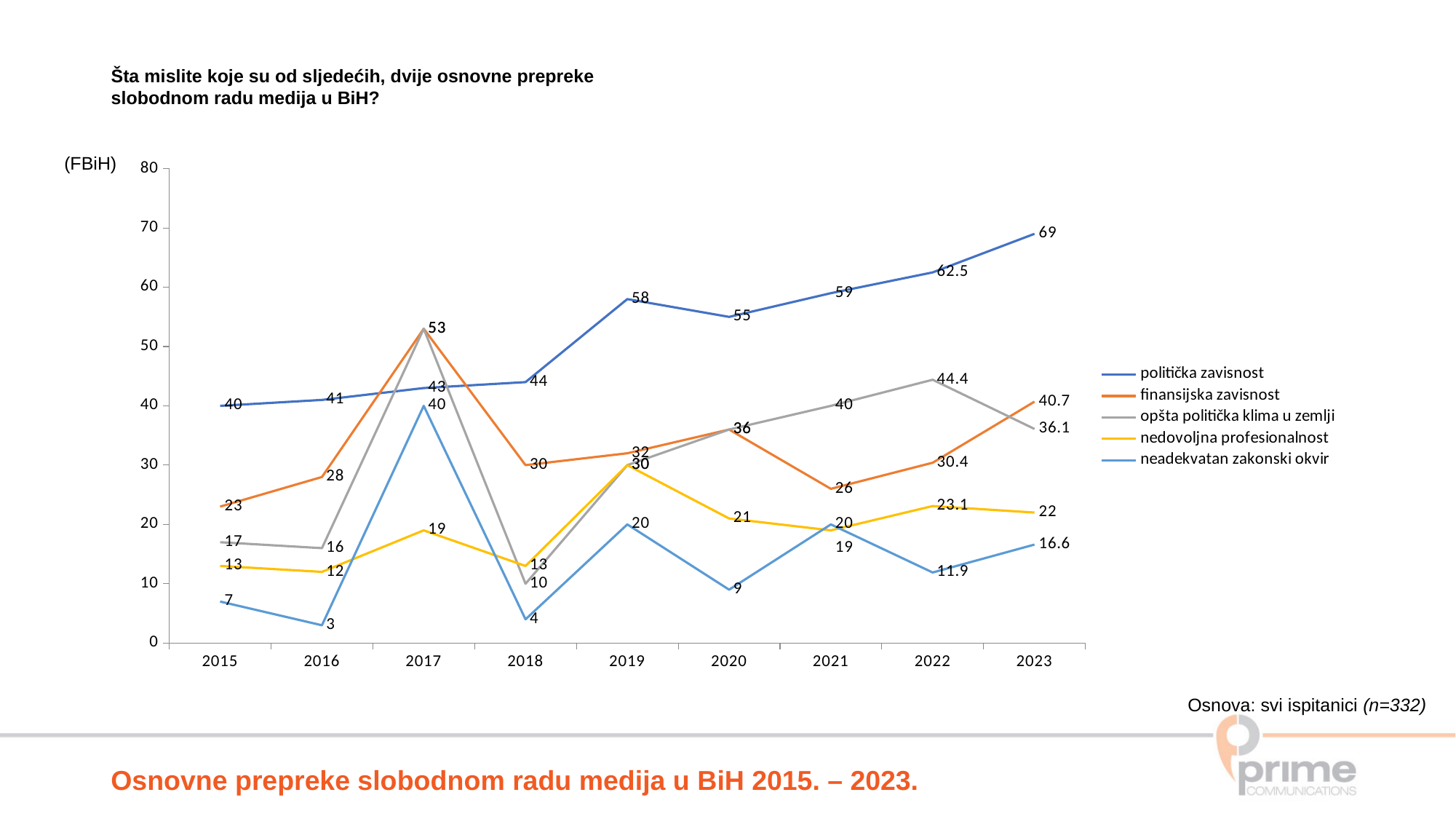
In which year is neadekvatan zakonski okvir at its lowest value? 2016 How many series does the legend list? 5 In which year does politička zavisnost reach its highest value? 2023 Which is larger in 2023: finansijska zavisnost or opšta politička klima u zemlji? finansijska zavisnost What is the value for politička zavisnost in 2023? 69 Does politička zavisnost generally rise or fall from 2015 to 2023? rise What is the difference between politička zavisnost in 2023 and in 2015? 29 What is the value for finansijska zavisnost in 2022? 30.4 What is the value for opšta politička klima u zemlji in 2022? 44.4 What type of chart is shown on the slide? line chart How many years are shown on the x axis? 9 What is the value for neadekvatan zakonski okvir in 2016? 3